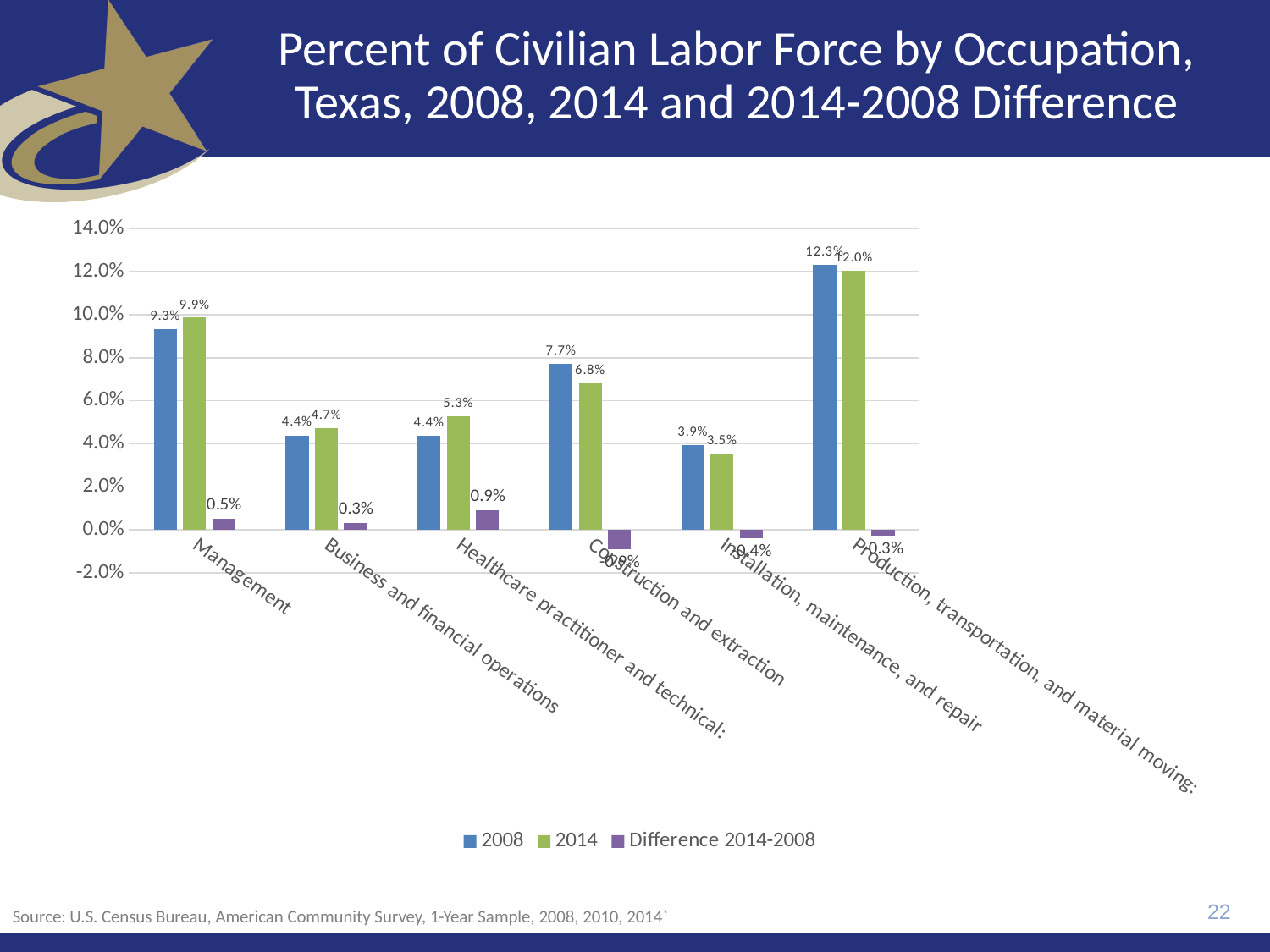
How many series does the legend list? 3 Which occupation has the lowest 2008 value? Installation, maintenance, and repair What is the Difference 2014-2008 value for Management? 0.5% How many occupation categories are shown on the x axis? 6 What is the difference between the 2008 and 2014 values for Construction and extraction? 0.9% What is the title of the chart? Percent of Civilian Labor Force by Occupation, Texas, 2008, 2014 and 2014-2008 Difference For Construction and extraction, which is larger, the 2008 value or the 2014 value? 2008 Is the 2008 value for Production, transportation, and material moving greater or less than 10.0%? greater What is the 2014 value for Healthcare practitioner and technical? 5.3% What is the 2008 value for Management? 9.3% Which occupation has the highest 2014 value? Production, transportation, and material moving What kind of chart is shown on the slide? bar chart